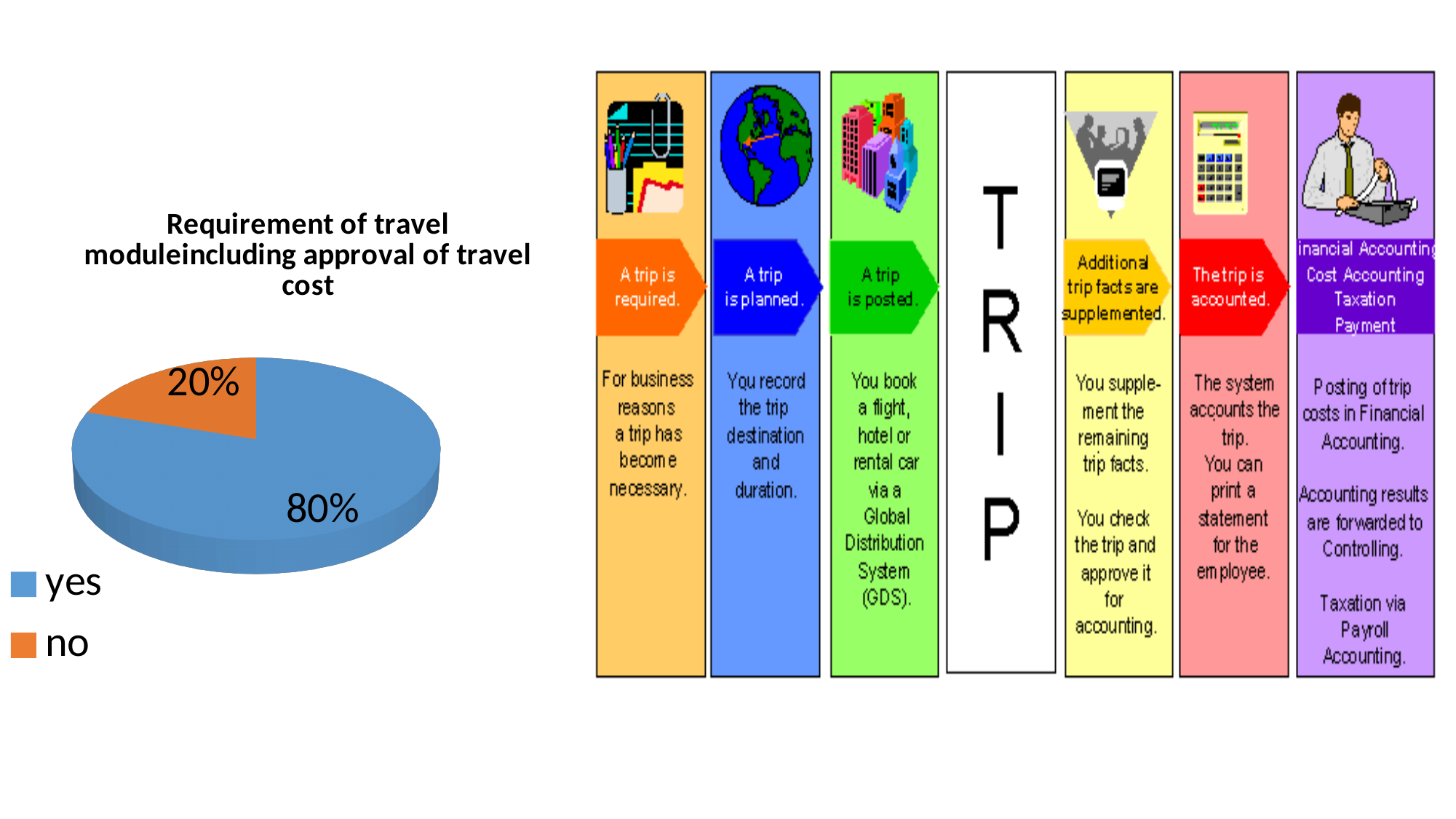
What colour is the "yes" slice in the pie chart? blue How many categories does the pie chart show? 2 What is the value for "yes" in the pie chart? 80% Which category has the largest share of the pie chart? yes Which category has the smallest share of the pie chart? no What kind of chart is shown on the slide? pie chart Which is larger in the pie chart, "yes" or "no"? yes What share of the pie does the "no" slice represent? 20% What is the difference between the "yes" and "no" shares in the pie chart? 60% What is the value for "no" in the pie chart? 20% What is the title of the pie chart? Requirement of travel moduleincluding approval of travel cost